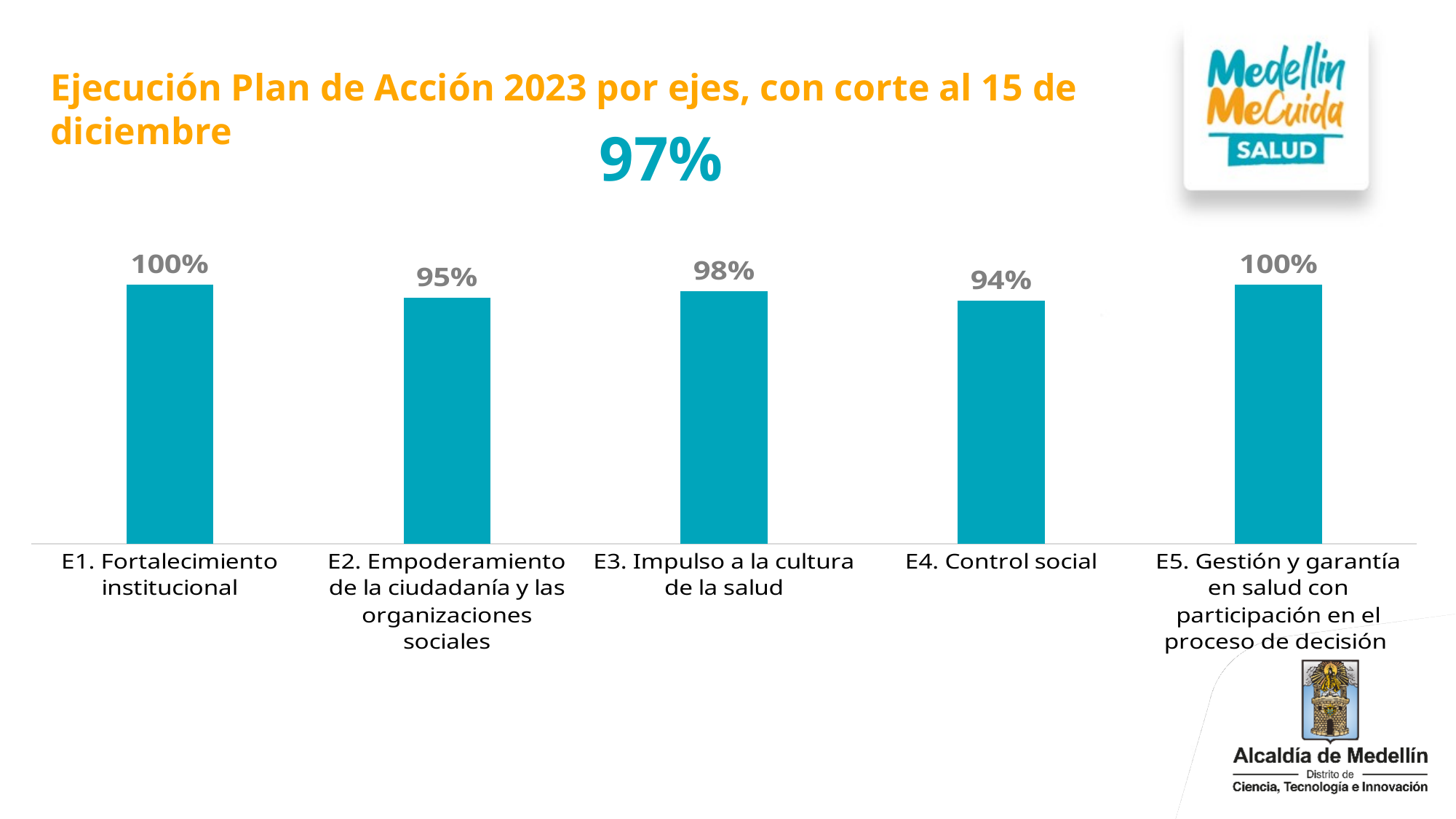
How many categories are shown in the chart? 5 What is the value for E2. Empoderamiento de la ciudadanía y las organizaciones sociales? 95% What kind of chart is shown on the slide? Bar chart What is the value for E1. Fortalecimiento institucional? 100% What is the difference between the values for E1. Fortalecimiento institucional and E2. Empoderamiento de la ciudadanía y las organizaciones sociales? 5% What is the difference between the values for E3. Impulso a la cultura de la salud and E4. Control social? 4% Which is larger, the value for E2. Empoderamiento de la ciudadanía y las organizaciones sociales or the value for E3. Impulso a la cultura de la salud? E3. Impulso a la cultura de la salud What is the value for E4. Control social? 94% Which categories share the highest value of 100%? E1. Fortalecimiento institucional and E5. Gestión y garantía en salud con participación en el proceso de decisión What overall percentage is displayed in large text above the chart? 97% What is the value for E3. Impulso a la cultura de la salud? 98% Which category has the lowest value? E4. Control social